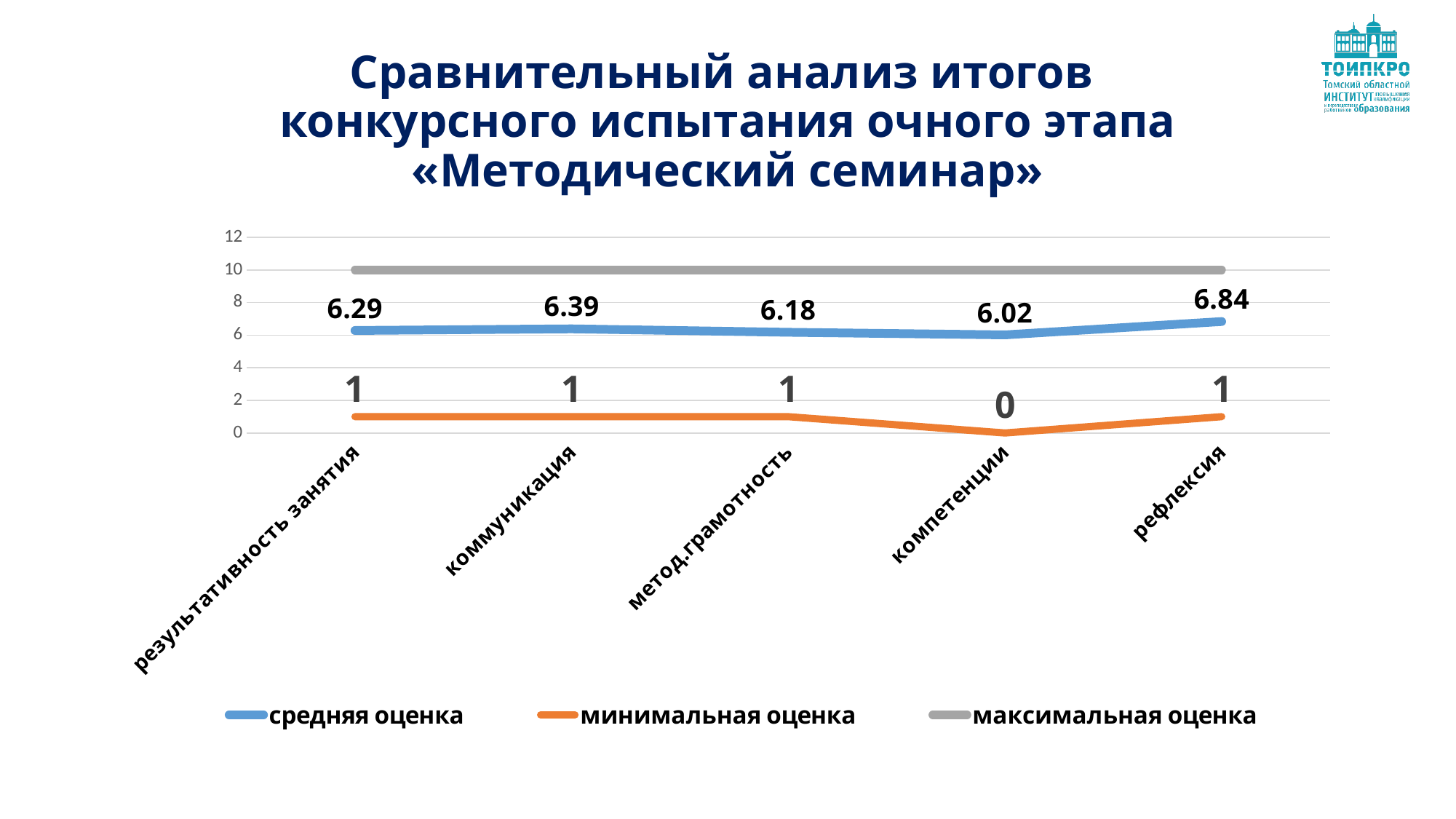
What kind of chart is shown on the slide? line chart Which colour is used for the минимальная оценка series? orange Which category has the lowest average score (средняя оценка)? компетенции What is the average score (средняя оценка) for коммуникация? 6.39 Which is larger: the average score for результативность занятия or for метод.грамотность? результативность занятия What is the minimum score (минимальная оценка) for компетенции? 0 What is the average score (средняя оценка) for компетенции? 6.02 How many categories are shown on the x axis? 5 What is the difference between the average score for рефлексия and the average score for компетенции? 0.82 Which category has the highest average score (средняя оценка)? рефлексия Is the value of the максимальная оценка line greater or less than 8? greater How many series does the legend list? 3